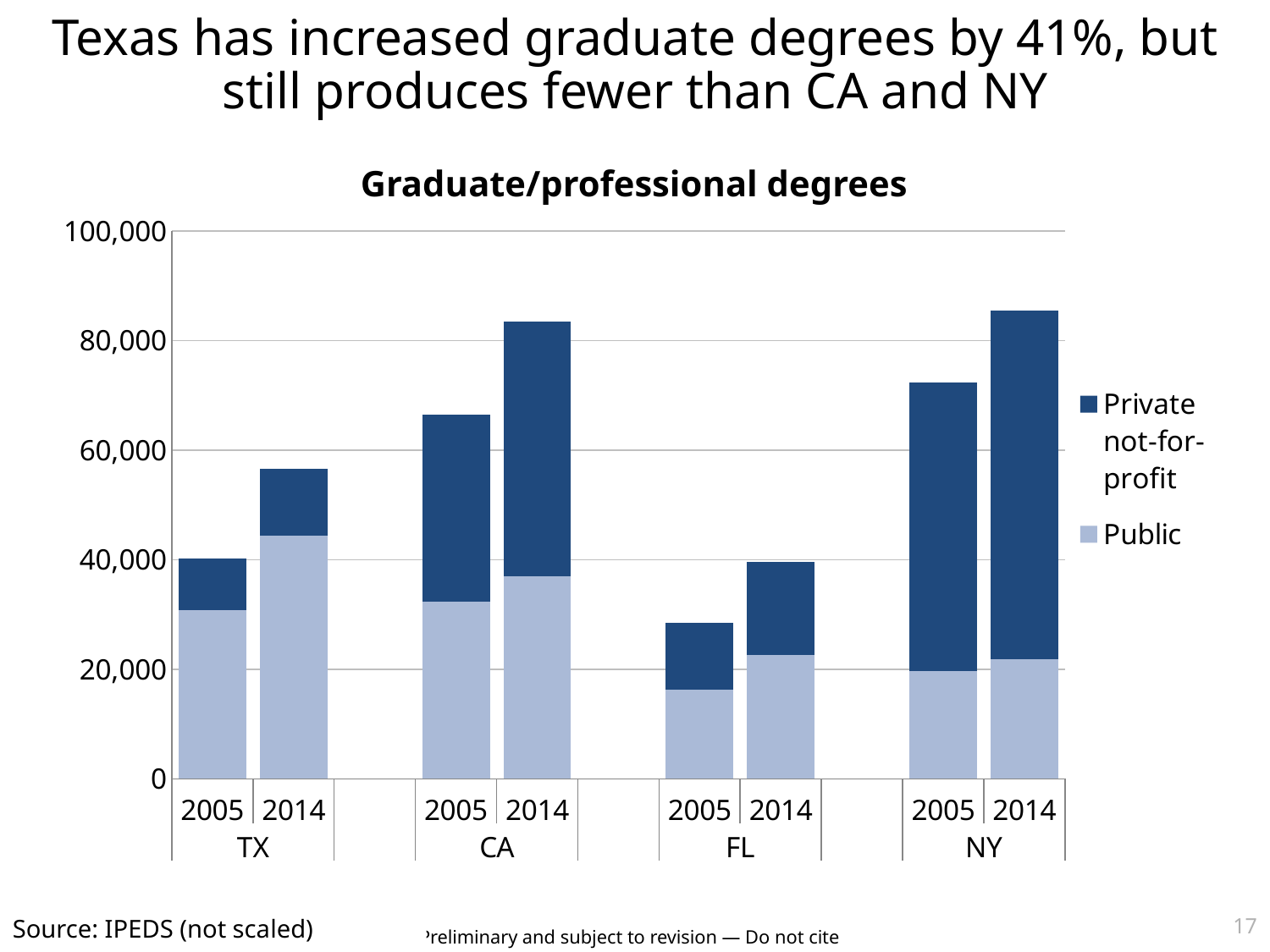
Which bar has the smallest Public segment? FL 2005 Is the Public segment for NY 2014 greater or less than 40,000? less Is the total for CA 2014 greater or less than 80,000? greater Which state and year has the lowest total of graduate/professional degrees? FL 2005 Which bar has the largest Public segment? TX 2014 What is the title of the chart? Graduate/professional degrees How many series does the legend list? 2 What kind of chart is shown on the slide? Stacked bar chart Do the total graduate/professional degrees for TX rise or fall from 2005 to 2014? Rise Is the total for TX 2014 greater or less than 50,000? greater Which is larger, the total for NY 2005 or the total for CA 2005? NY 2005 How many bars are plotted in the chart? 8